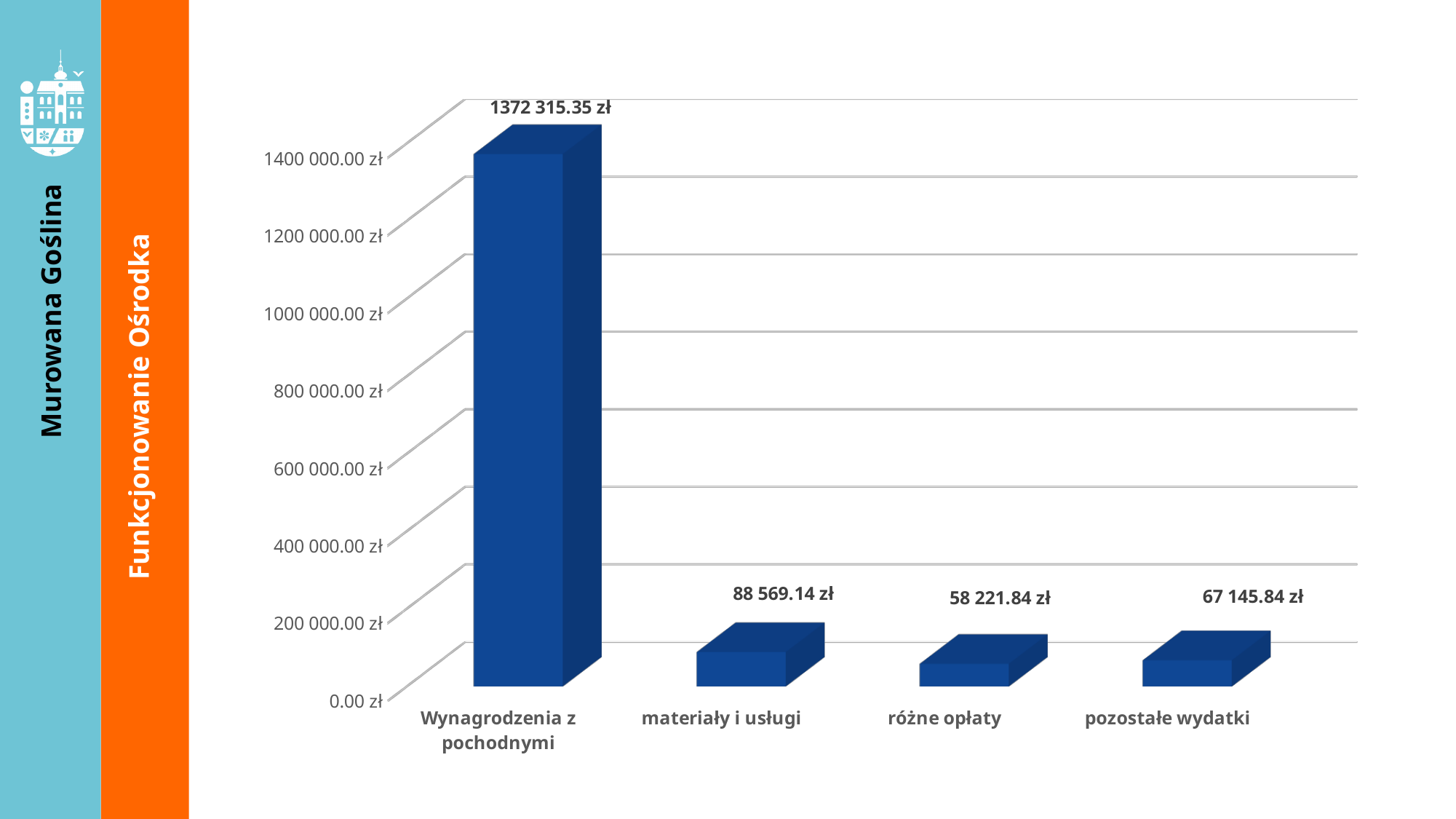
How many categories are shown on the chart? 4 What is the value for Wynagrodzenia z pochodnymi? 1372 315.35 zł What is the value for pozostałe wydatki? 67 145.84 zł What is the value for materiały i usługi? 88 569.14 zł Which category has the lowest value? różne opłaty What is the difference between the values for materiały i usługi and różne opłaty? 30 347.30 zł What kind of chart is shown on the slide? bar chart What is the value for różne opłaty? 58 221.84 zł Is the value for Wynagrodzenia z pochodnymi greater or less than 1200 000.00 zł? greater Which is larger, the value for materiały i usługi or the value for pozostałe wydatki? materiały i usługi Which category has the highest value? Wynagrodzenia z pochodnymi What is the difference between the values for pozostałe wydatki and różne opłaty? 8 924.00 zł